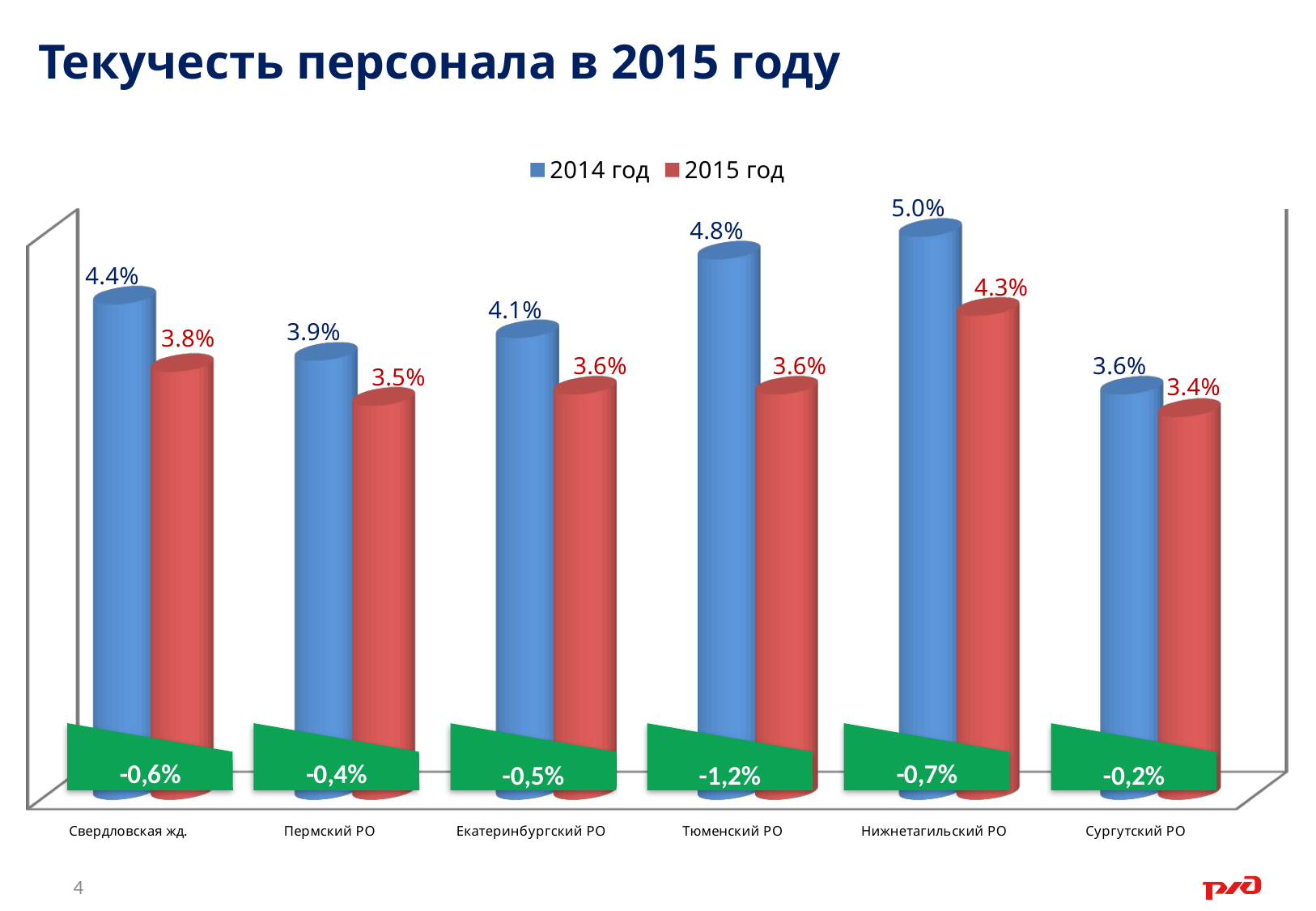
How many categories are shown on the x axis? 6 What is the title of the slide? Текучесть персонала в 2015 году Which is larger for Пермский РО: the 2014 год value or the 2015 год value? 2014 год What was the staff turnover for Сургутский РО in 2015 год? 3.4% How many series does the legend list? 2 Which category has the highest value for 2014 год? Нижнетагильский РО What kind of chart is shown on the slide? Bar chart What was the staff turnover for Нижнетагильский РО in 2015 год? 4.3% Which category has the lowest value for 2015 год? Сургутский РО What was the staff turnover for Свердловская жд. in 2014 год? 4.4% What was the staff turnover for Тюменский РО in 2014 год? 4.8% What is the difference between the 2014 год and 2015 год values for Тюменский РО? 1.2%